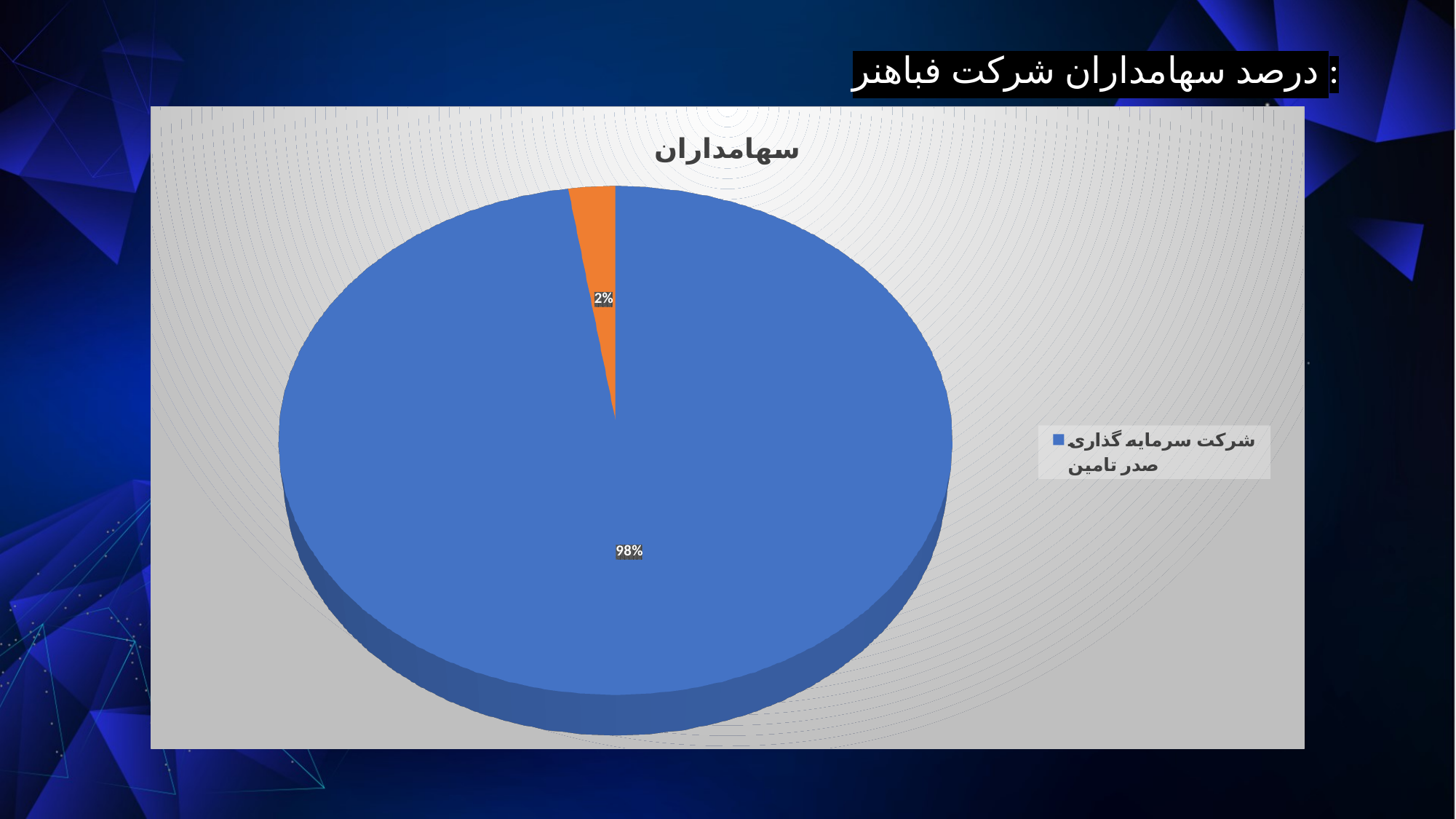
What is the difference in percentage points between the blue slice and the orange slice? 96 What share of the pie does شرکت سرمایه گذاری صدر تامین hold? 98% Is the share of the orange slice greater or less than 10%? less What colour is the slice for شرکت سرمایه گذاری صدر تامین? blue Which is larger, the blue slice or the orange slice? the blue slice What percentage is shown on the orange slice of the pie? 2% How many slices does the pie chart have? 2 What kind of chart is shown on the slide? pie chart What do the two labelled slices of the pie add up to? 100% What is the title of the pie chart? سهامداران How many entries does the legend list? 1 Which slice of the pie is the largest? شرکت سرمایه گذاری صدر تامین